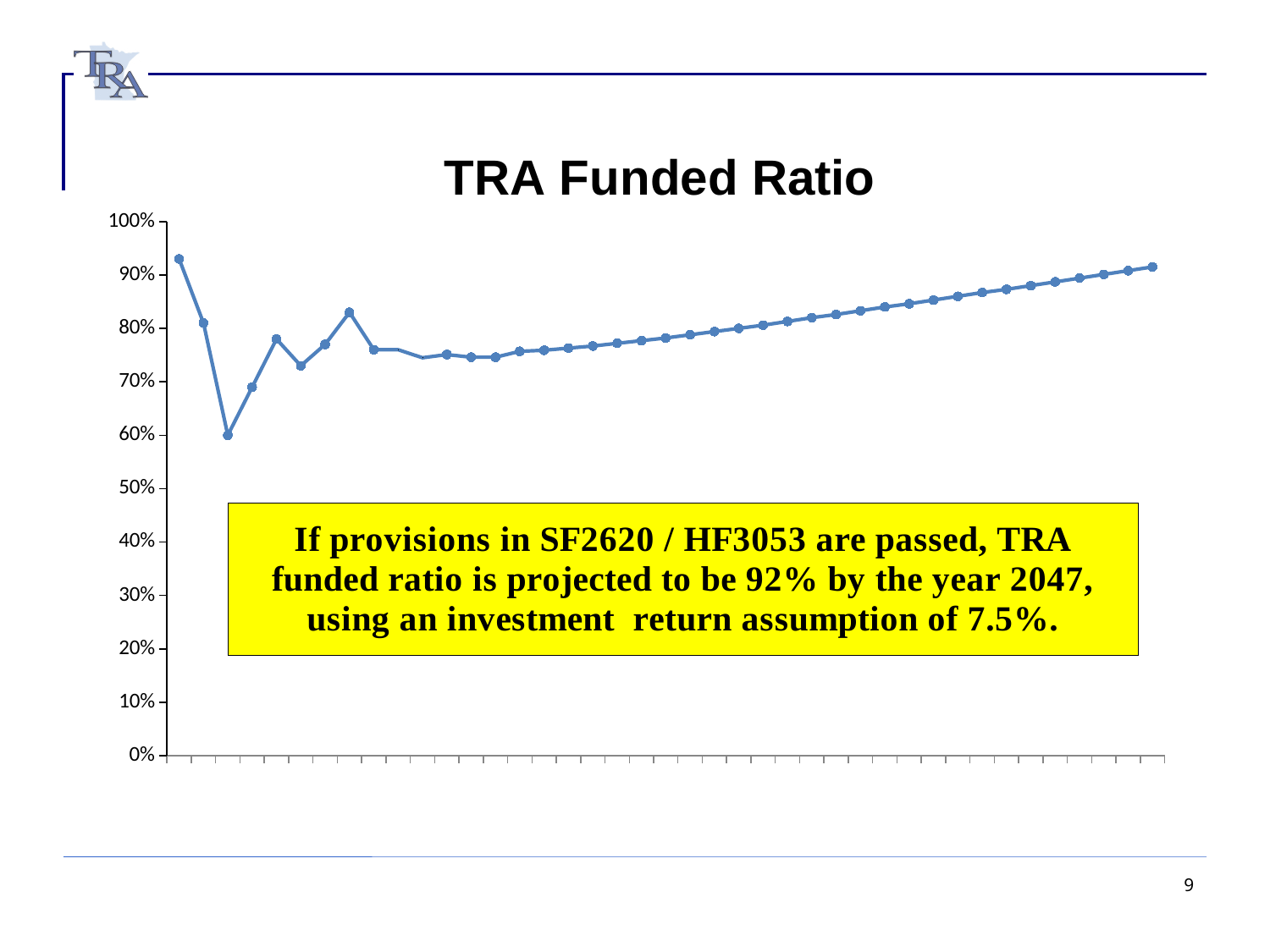
What is the highest value shown on the vertical axis? 100% How many lines are plotted on the chart? 1 Is the lowest point on the line greater or less than 50%? greater What is the title of the chart? TRA Funded Ratio Is the lowest point on the line greater or less than 70%? less What kind of chart is shown on the slide? Line chart Is the last point on the line greater or less than 80%? greater Over the right-hand half of the chart, do the values rise or fall along the x axis? rise Between the first and third points of the line, do the values rise or fall? fall